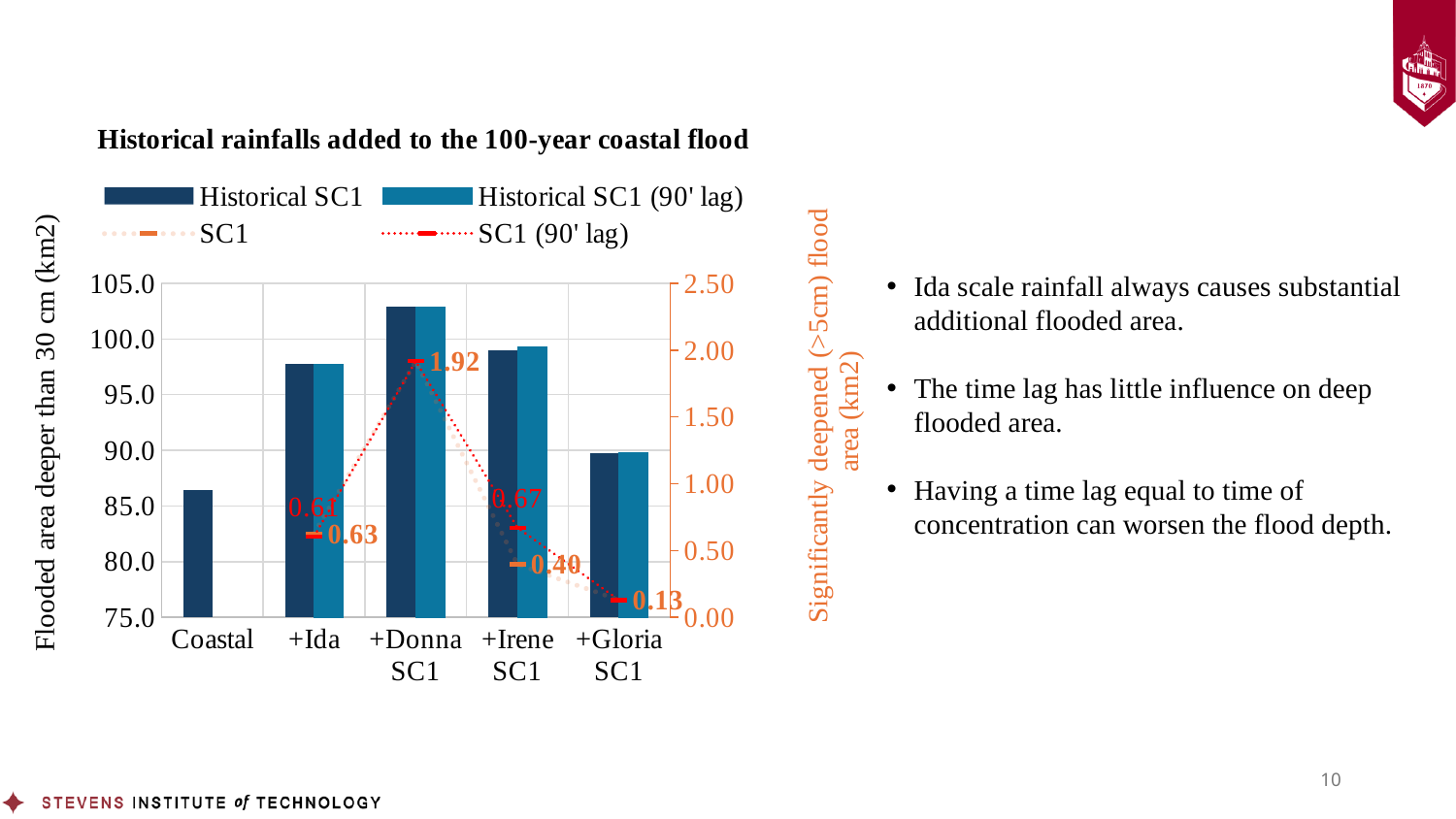
What is the SC1 (90' lag) value for +Gloria SC1? 0.13 What is the difference between the SC1 (90' lag) values for +Donna SC1 and +Gloria SC1? 1.79 Which category has the shortest Historical SC1 bar? Coastal Is the Historical SC1 value for +Donna SC1 greater or less than 100.0? greater What kind of chart is shown on the slide? bar chart (with line series) Which category has the tallest Historical SC1 bar? +Donna SC1 Which has the larger Historical SC1 bar, +Ida or +Gloria SC1? +Ida What is the title of the chart? Historical rainfalls added to the 100-year coastal flood Is the Historical SC1 value for Coastal greater or less than 90.0? less What is the SC1 (90' lag) value for +Donna SC1? 1.92 How many series does the chart legend list? 4 How many categories are shown on the x axis of the chart? 5